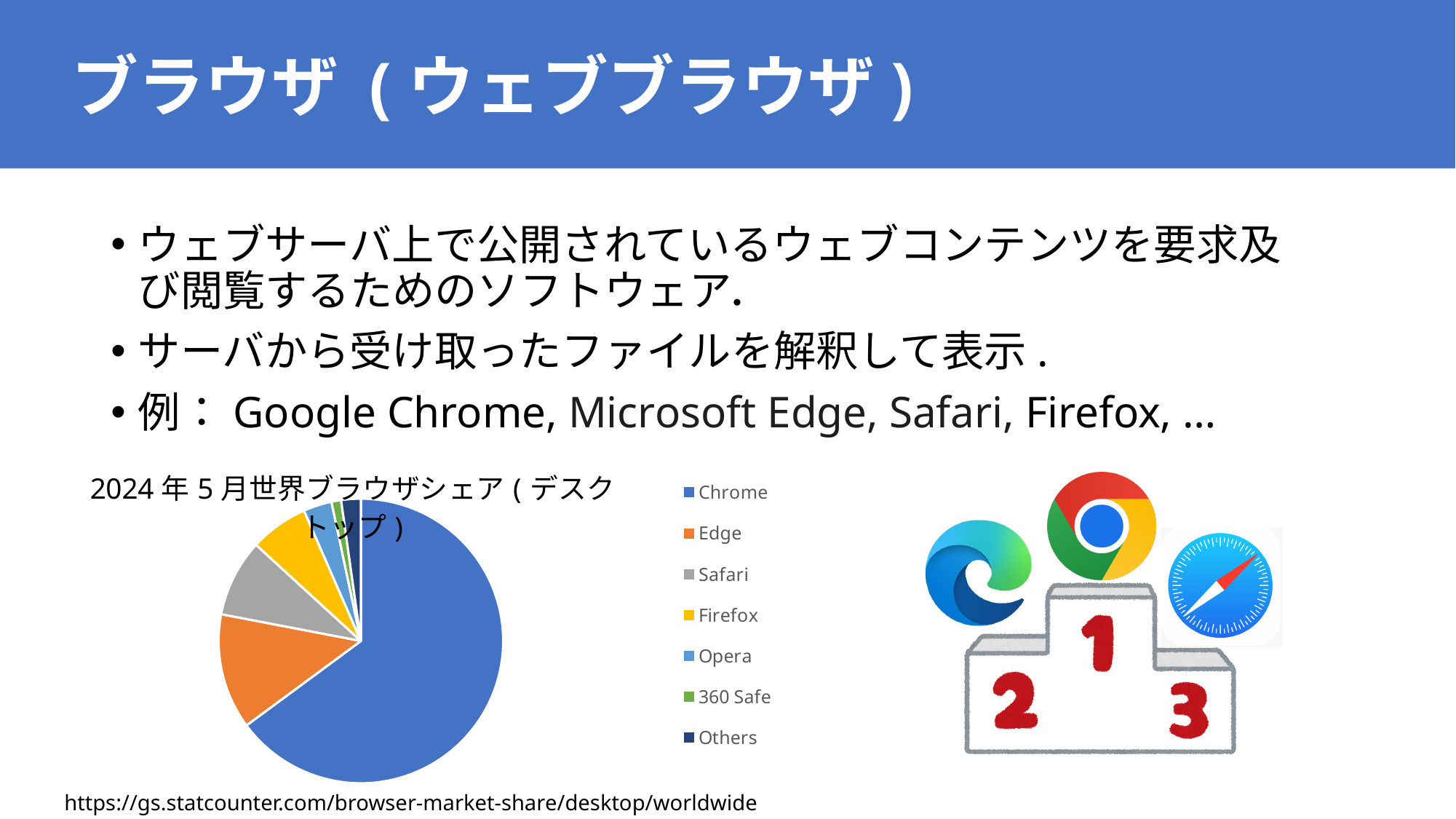
Which colour represents Edge in the pie chart's legend? orange What is the title of the pie chart? 2024年5月世界ブラウザシェア（デスクトップ） Which slice is larger in the pie chart, Edge or Safari? Edge Which slice is larger in the pie chart, Firefox or Opera? Firefox Which browser has the largest slice in the pie chart? Chrome Which slice is larger in the pie chart, Chrome or Edge? Chrome How many browser categories does the pie chart's legend list? 7 What kind of chart is shown on the slide? pie chart Which legend entry comes last in the pie chart's legend? Others